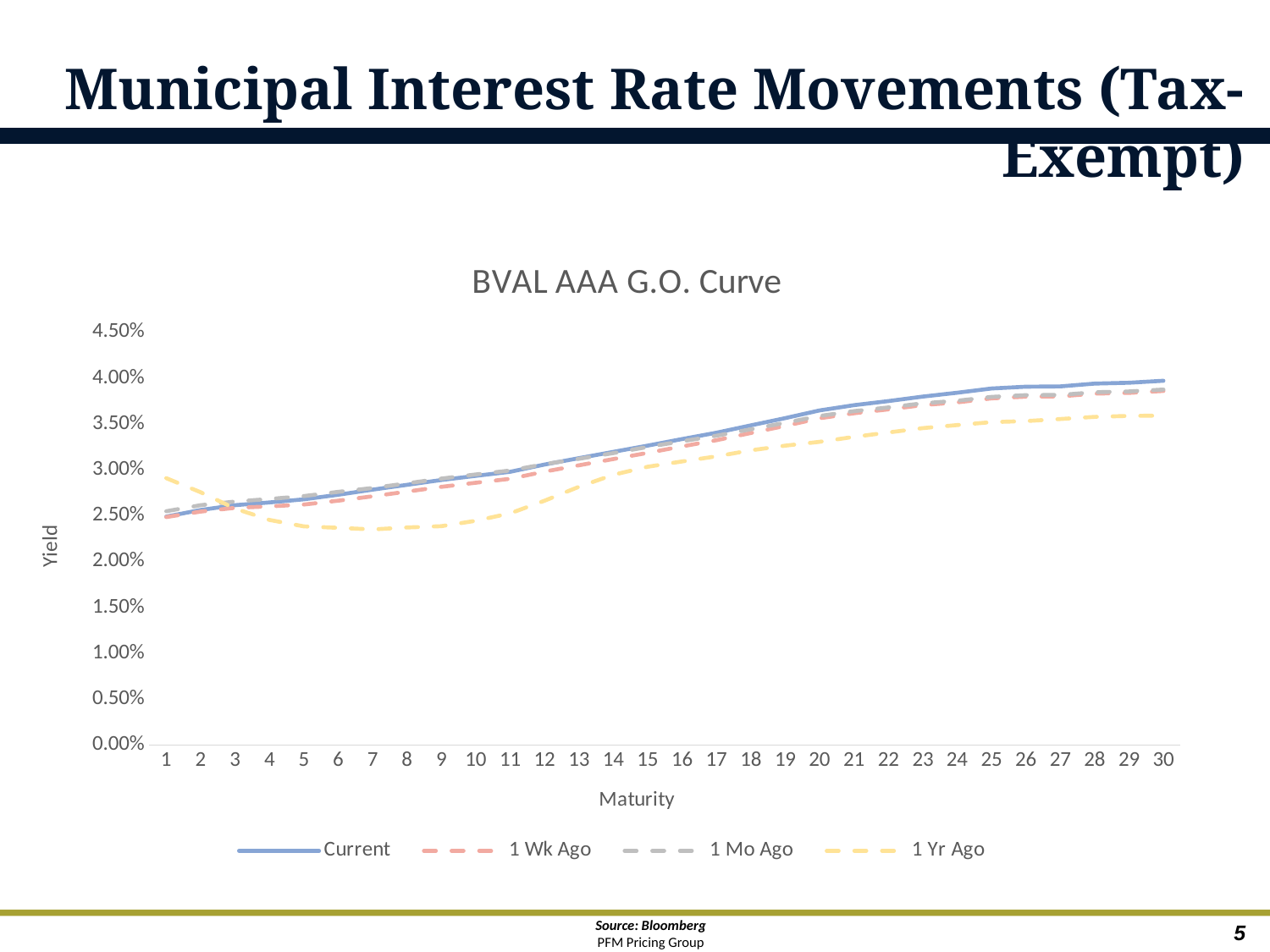
Is the Current yield at maturity 30 greater or less than 3.50%? greater How many maturity points are shown on the x axis? 30 How many series does the legend list? 4 At maturity 1, which is higher: the Current yield or the 1 Yr Ago yield? 1 Yr Ago What is the label of the y axis? Yield What is the title of the chart? BVAL AAA G.O. Curve Is the 1 Yr Ago yield at maturity 30 greater or less than 4.00%? less What kind of chart is shown on the slide? line chart Is the Current yield at maturity 1 greater or less than 3.00%? less Does the Current series rise or fall as maturity increases from 1 to 30? rise At maturity 30, which is higher: the Current yield or the 1 Yr Ago yield? Current